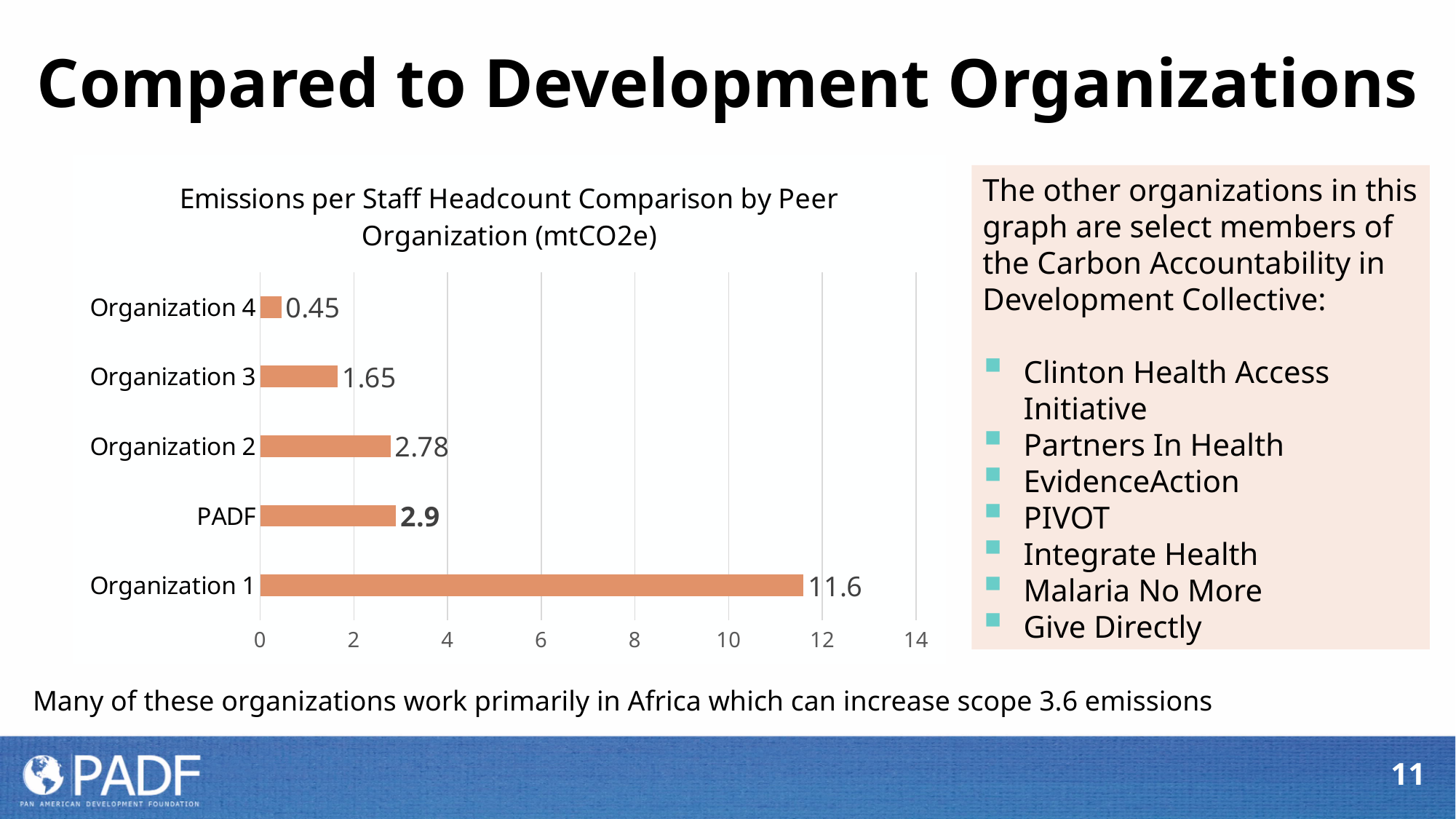
What kind of chart is shown on the slide? Bar chart Which organization has the lowest emissions per staff headcount? Organization 4 What is the difference between the values for Organization 2 and Organization 3? 1.13 Which organization has the highest emissions per staff headcount? Organization 1 Which is larger, the value for Organization 2 or the value for Organization 3? Organization 2 What is the title of the chart? Emissions per Staff Headcount Comparison by Peer Organization (mtCO2e) What is the value for Organization 4? 0.45 What is the difference between the values for Organization 1 and PADF? 8.7 What is the value for Organization 3? 1.65 What is the value for Organization 1? 11.6 How many organizations are shown in the chart? 5 What is the value for PADF? 2.9